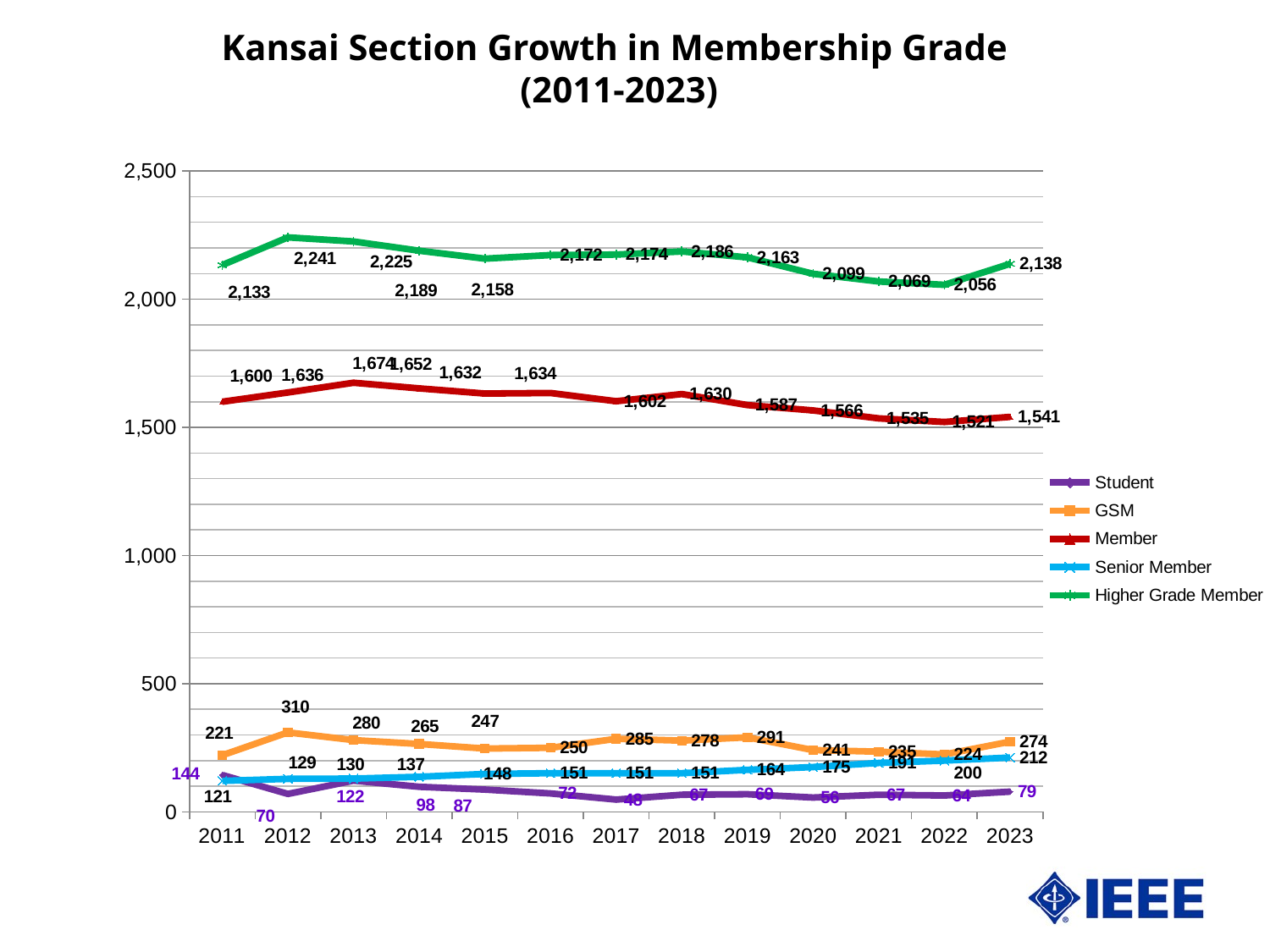
What is the difference between the Higher Grade Member values in 2012 and 2022? 185 What is the value for Senior Member in 2021? 191 What is the value for GSM in 2019? 291 Which is larger in 2011, the Student value or the Senior Member value? Student How many years are plotted along the x axis? 13 In which year is the Member series at its highest? 2013 What is the value for Member in 2023? 1,541 How many series does the legend list? 5 What is the value for Higher Grade Member in 2012? 2,241 What kind of chart is shown on the slide? Line chart In which year is the Higher Grade Member series at its lowest? 2022 Does the Senior Member series generally rise or fall from 2011 to 2023? Rise